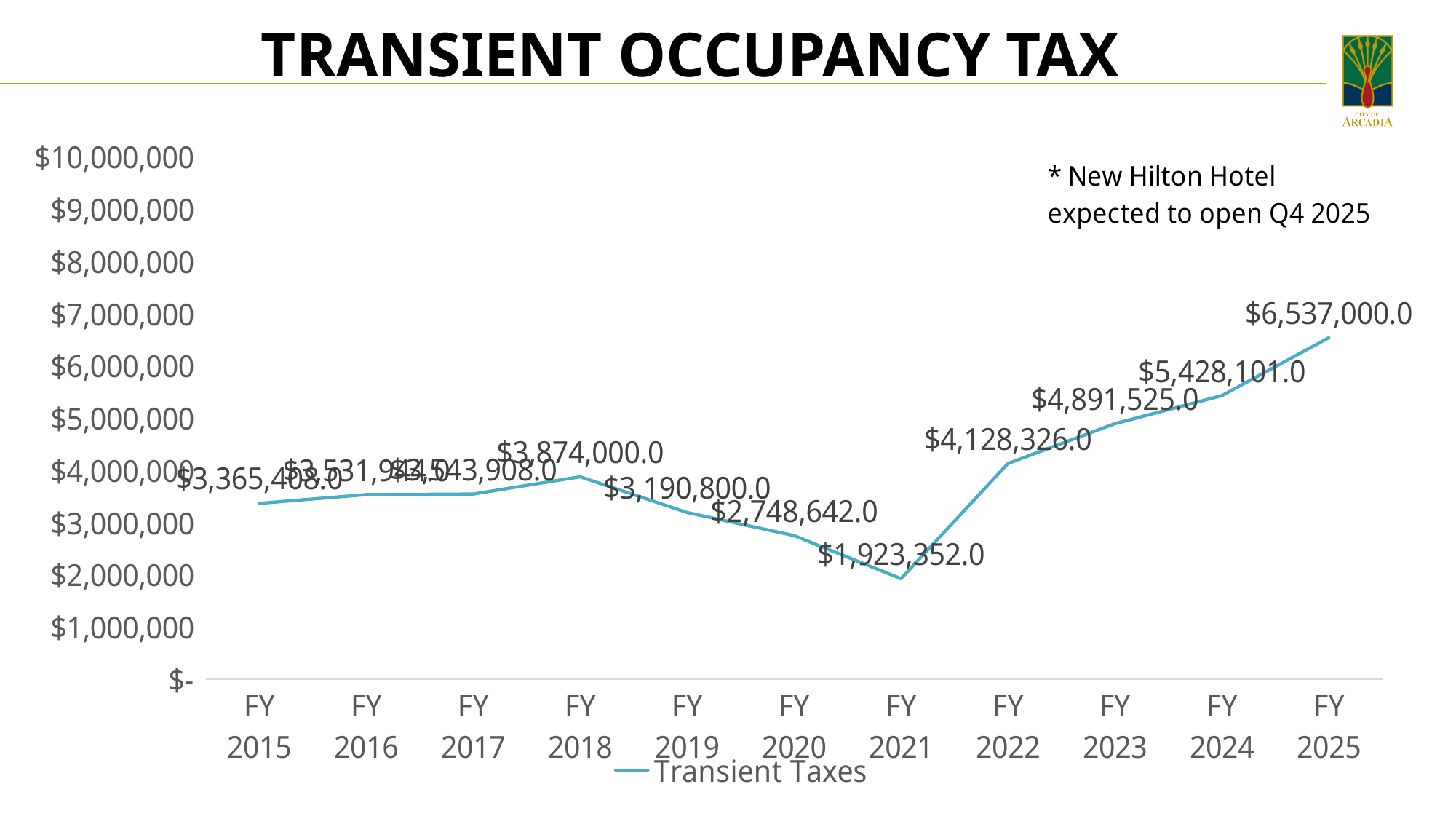
How many fiscal years are plotted on the chart? 11 Which is larger, the Transient Taxes value for FY 2019 or for FY 2020? FY 2019 What is the difference between the Transient Taxes values for FY 2025 and FY 2024? $1,108,899.0 What is the value of Transient Taxes for FY 2023? $4,891,525.0 Is the Transient Taxes value for FY 2016 greater or less than $3,000,000? greater How many series does the legend list? 1 What is the value of Transient Taxes for FY 2018? $3,874,000.0 Which fiscal year has the highest Transient Taxes value? FY 2025 What kind of chart is shown on the slide? line chart Which fiscal year has the lowest Transient Taxes value? FY 2021 What is the value of Transient Taxes for FY 2025? $6,537,000.0 What is the value of Transient Taxes for FY 2021? $1,923,352.0